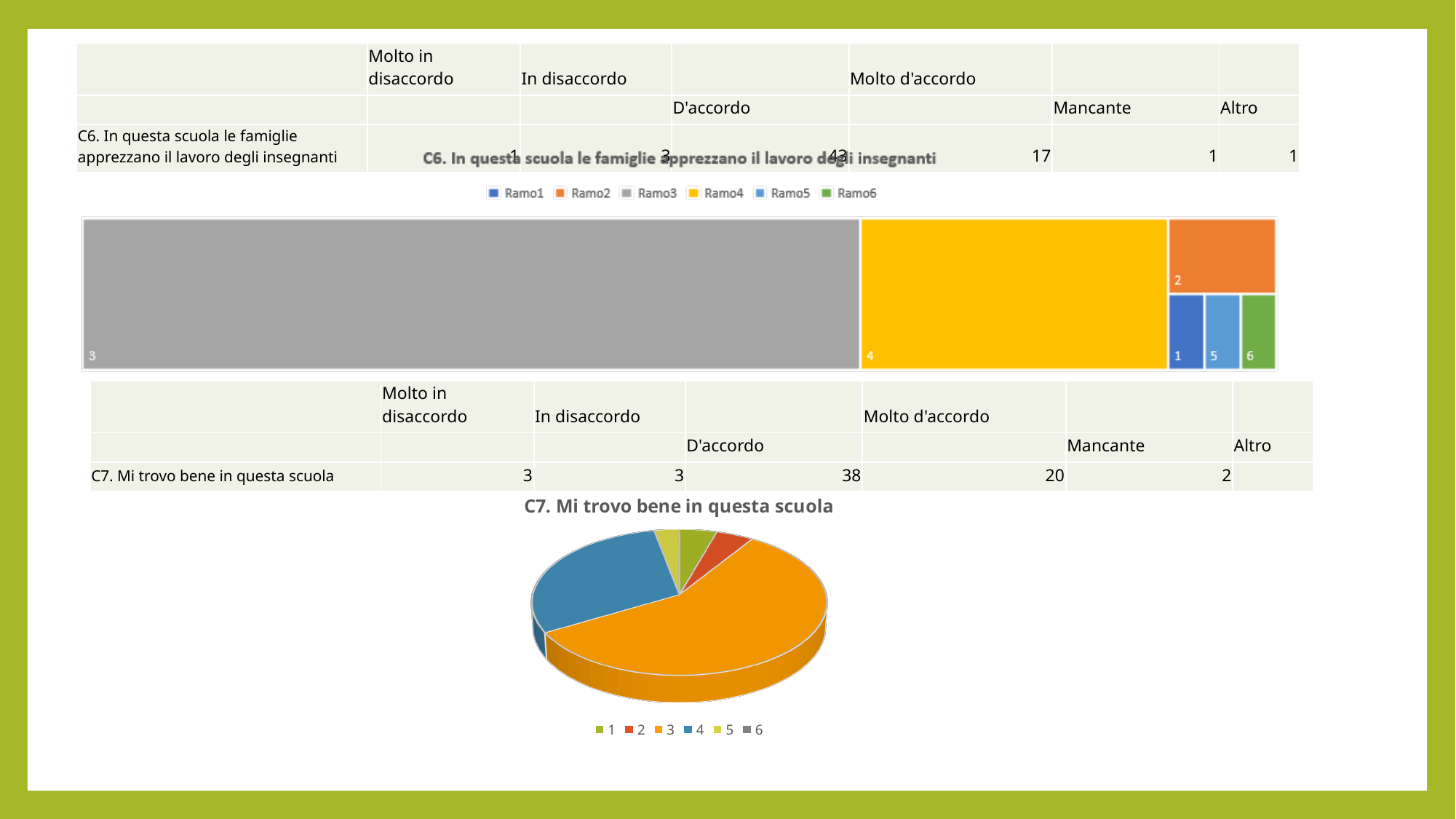
In the C6 treemap, which branch occupies the largest area? Ramo3 In the C6 treemap, which is larger, Ramo2 or Ramo1? Ramo2 In the C7 pie chart, which slice is the largest? 3 In the C7 pie chart, which is larger, slice 4 or slice 2? 4 What kind of chart is the chart titled "C6. In questa scuola le famiglie apprezzano il lavoro degli insegnanti"? Treemap In the C6 treemap, which is larger, Ramo4 or Ramo2? Ramo4 In the C6 treemap, what colour is the box for Ramo3? Grey What kind of chart is the chart titled "C7. Mi trovo bene in questa scuola"? Pie chart In the C6 treemap, how many entries does the legend list? 6 In the C7 pie chart, how many entries does the legend list? 6 In the C6 treemap, how many boxes are shown? 6 In the C7 pie chart, what colour is the largest slice? Orange